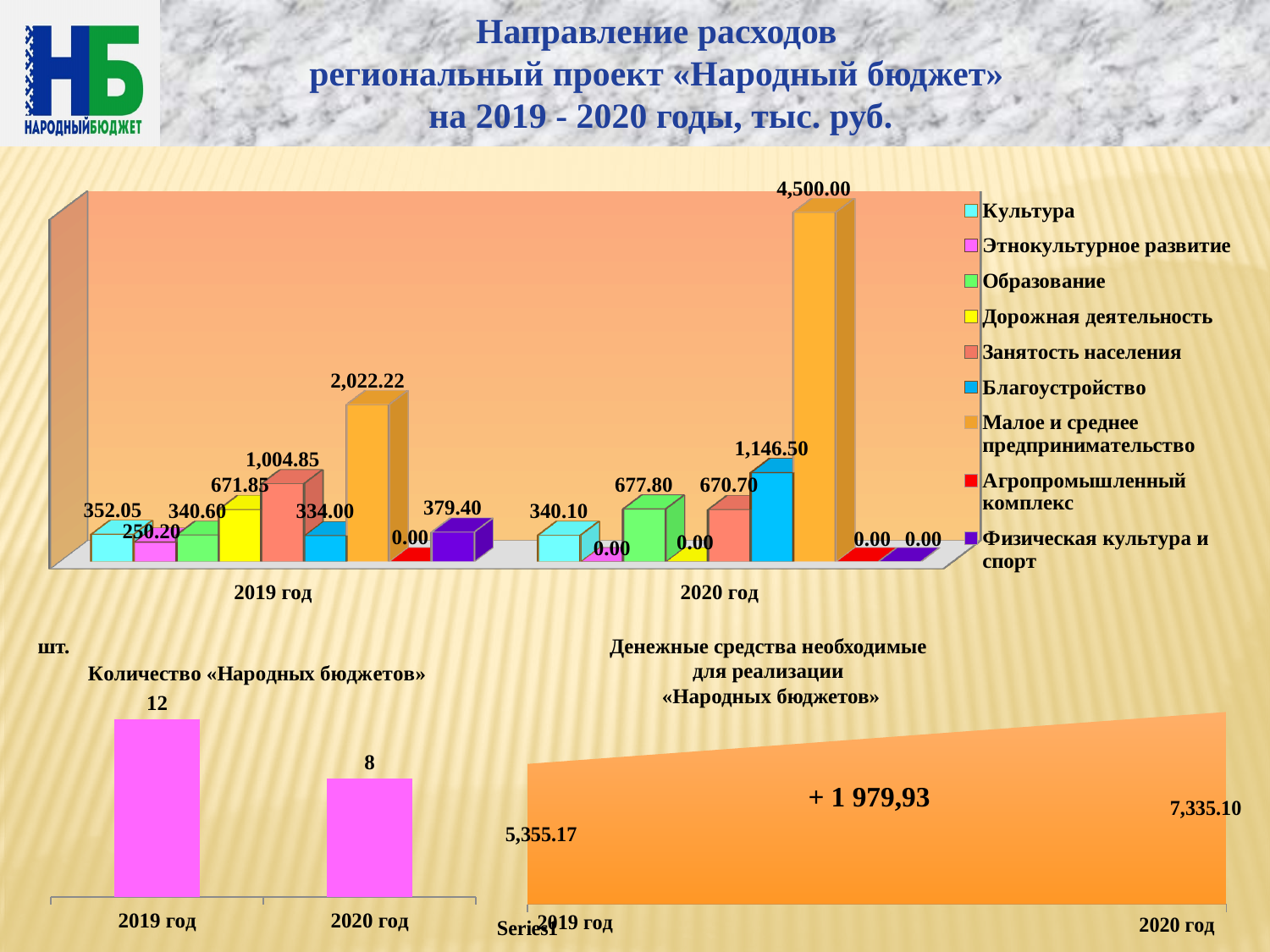
In the chart titled Количество «Народных бюджетов», what is the difference between 2019 год and 2020 год? 4 In the chart titled Денежные средства необходимые для реализации «Народных бюджетов», what is the value for 2020 год? 7,335.10 In the chart titled Количество «Народных бюджетов», what is the value for 2019 год? 12 In the chart titled Денежные средства необходимые для реализации «Народных бюджетов», do the values rise or fall from 2019 год to 2020 год? Rise In the top chart, which is larger: Образование in 2019 год or Образование in 2020 год? Образование in 2020 год In the top chart, what is the value for Благоустройство in 2020 год? 1,146.50 How many series does the legend of the top chart list? 9 In the top chart, which series has the highest value in 2019 год? Малое и среднее предпринимательство In the top chart, what is the value for Занятость населения in 2019 год? 1,004.85 In the top chart, what colour is the Благоустройство series? Blue In the top chart, what is the value for Малое и среднее предпринимательство in 2020 год? 4,500.00 In the top chart, what is the difference between the Малое и среднее предпринимательство values for 2020 год and 2019 год? 2,477.78